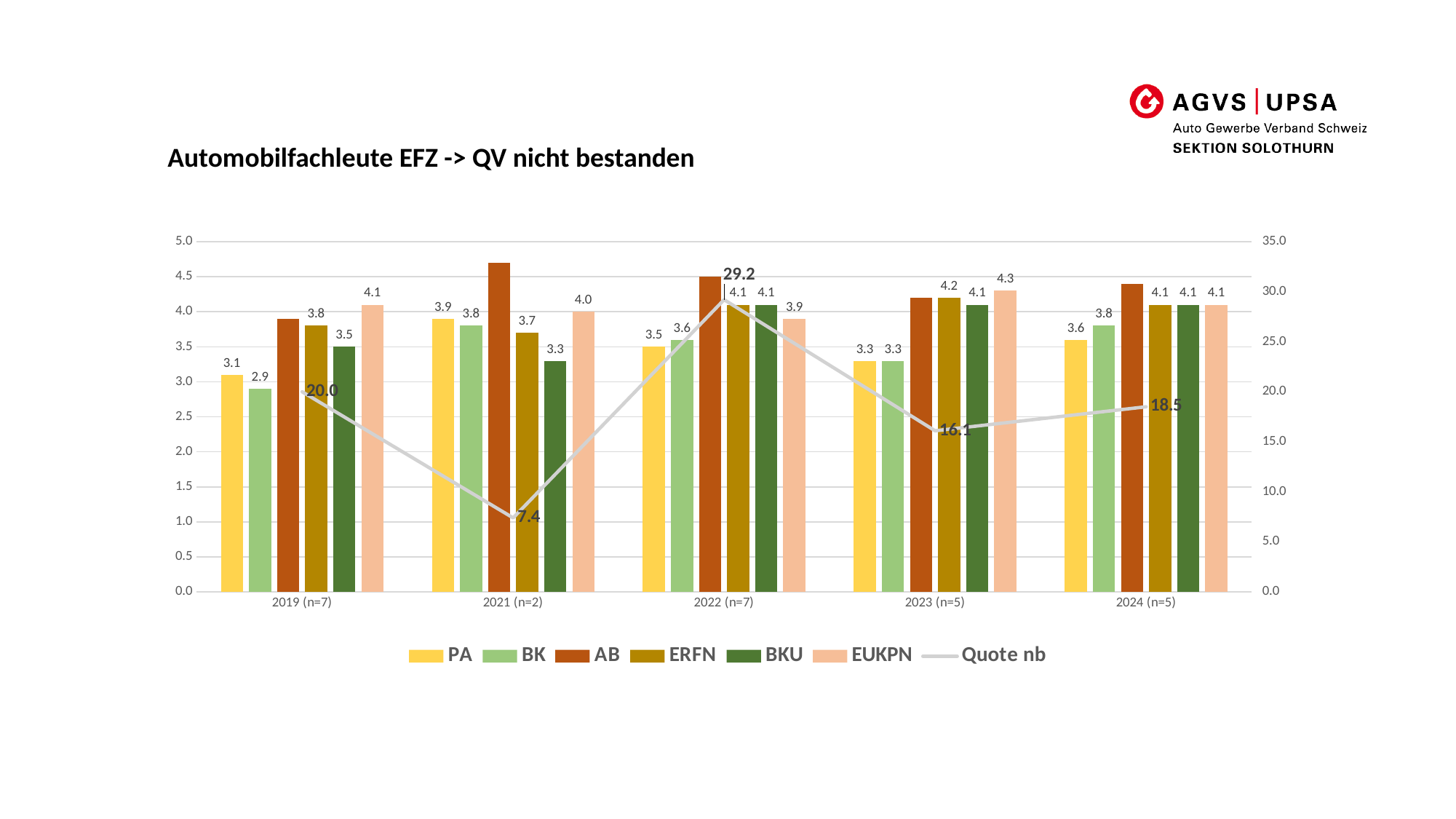
What is the difference between the Quote nb values for 2022 (n=7) and 2021 (n=2)? 21.8 Does the Quote nb line rise or fall from 2022 (n=7) to 2023 (n=5)? fall What is the Quote nb value for 2022 (n=7)? 29.2 What is the value of PA for 2019 (n=7)? 3.1 What is the value of EUKPN for 2023 (n=5)? 4.3 How many year categories are shown on the x axis? 5 What is the value of BKU for 2021 (n=2)? 3.3 In which year is the Quote nb line at its highest? 2022 (n=7) Is the AB value for 2021 (n=2) greater or less than 4.5 on the left axis? greater Which is larger, the BK value for 2019 (n=7) or the BK value for 2021 (n=2)? 2021 (n=2) How many series does the legend list? 7 In which year is the Quote nb line at its lowest? 2021 (n=2)